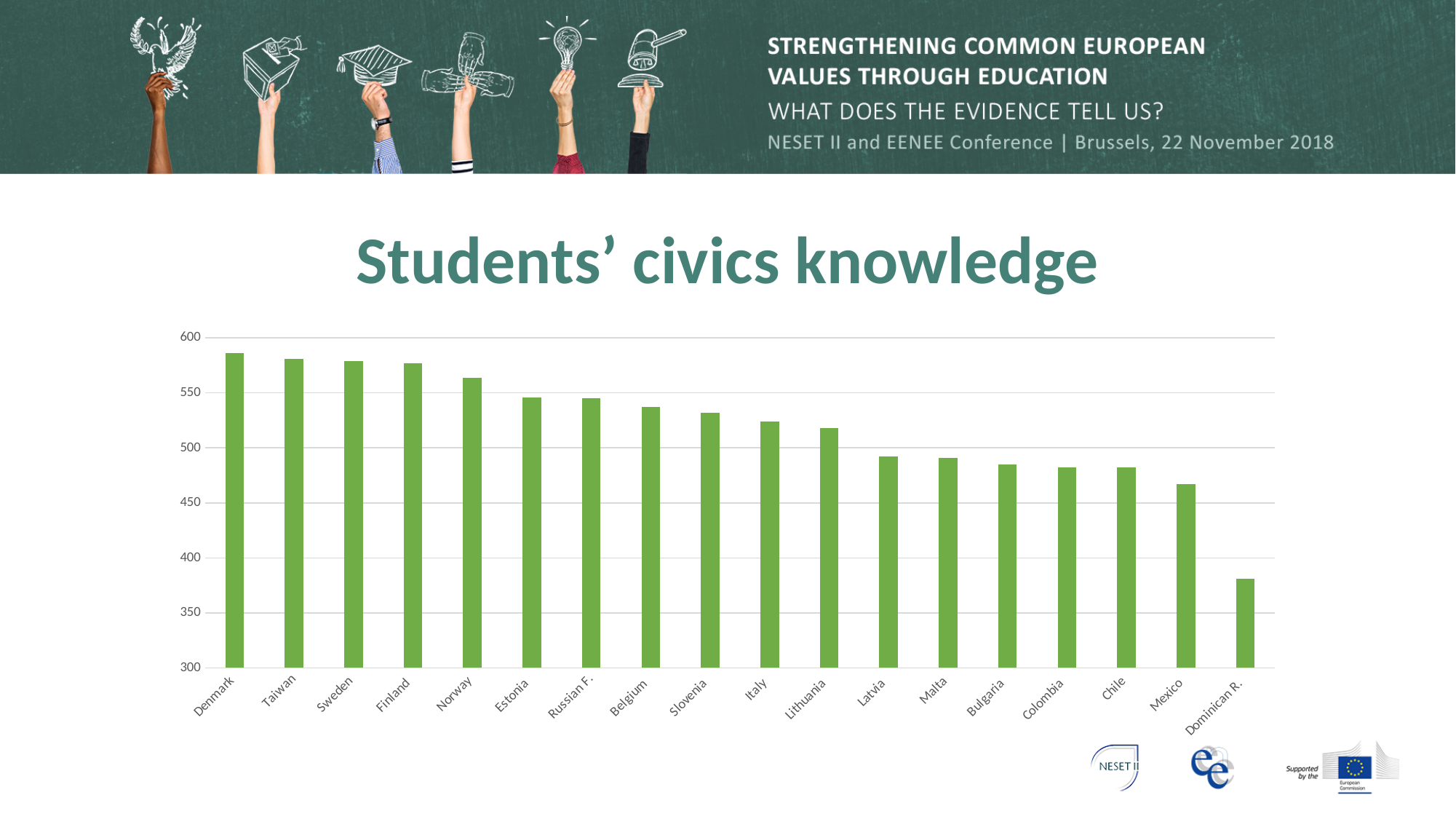
Do the values rise or fall moving from left to right along the x axis? fall Which country has the lowest bar in the chart? Dominican R. Is the value for Belgium greater or less than 550? less What is the title of the chart? Students' civics knowledge Is the value for Dominican R. greater or less than 400? less Which has a higher value, Norway or Mexico? Norway What kind of chart is shown on the slide? bar chart Which country has the highest bar in the chart? Denmark Is the value for Mexico greater or less than 500? less How many countries are shown on the x axis of the chart? 18